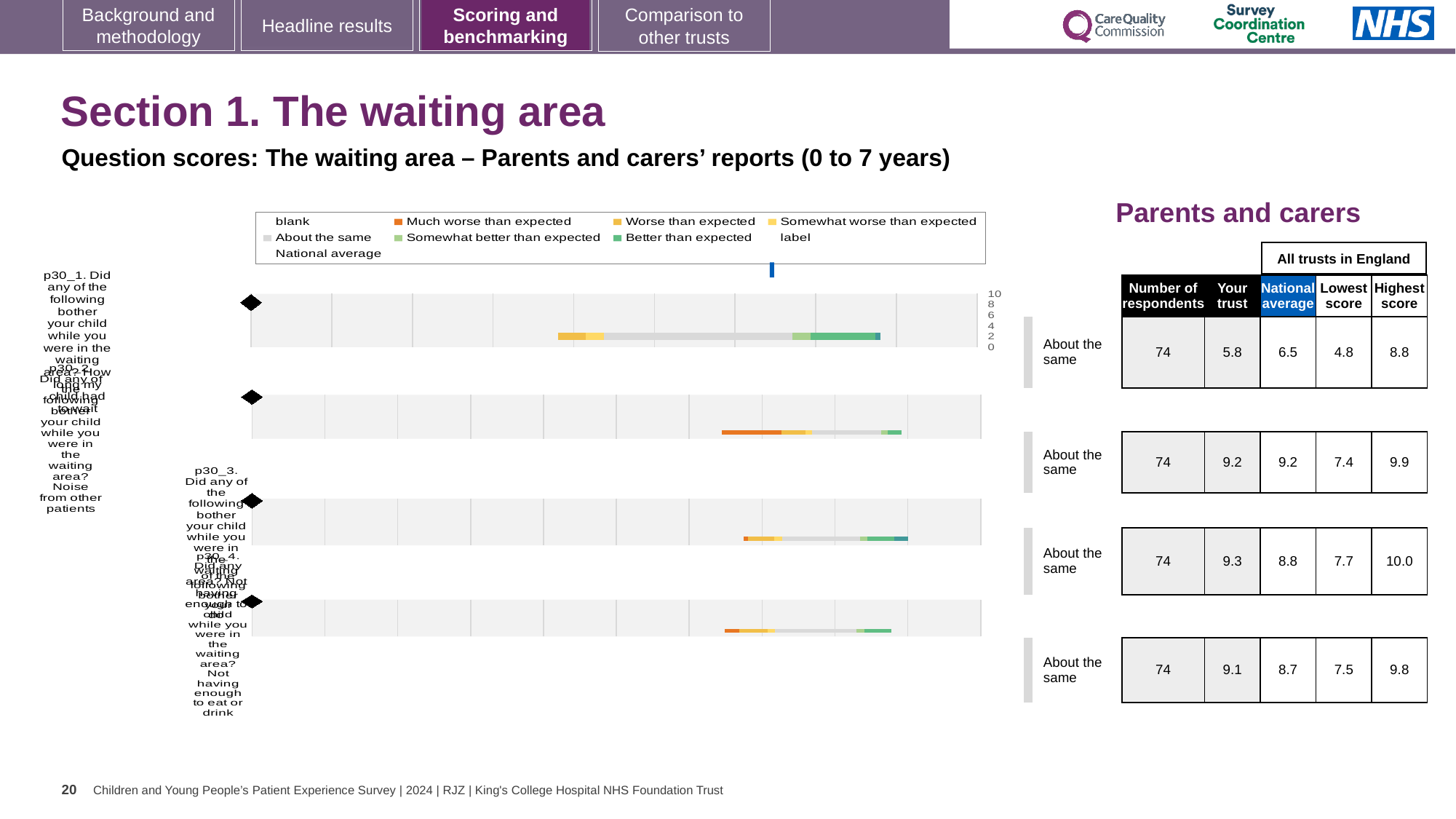
What is the lowest score among all trusts in England for the fourth question row (p30_4)? 7.5 Which question row has the lowest 'Your trust' score? the first row (p30_1), 5.8 What is the national average for the first question row (p30_1)? 6.5 What is the difference between the highest score and the lowest score for the first question row (p30_1)? 4.0 How many respondents are listed for the second question row (p30_2)? 74 What kind of chart is used to show the question scores on this slide? bar chart What is the highest score among all trusts in England for the third question row (p30_3)? 10.0 What colour in the legend represents 'Much worse than expected'? orange How many question charts (rows) are shown on the slide? 4 What is the 'Your trust' score for the first question row (p30_1)? 5.8 For the first question row (p30_1), which is larger: the 'Your trust' score or the national average? national average Which question row has the highest 'Your trust' score? the third row (p30_3), 9.3